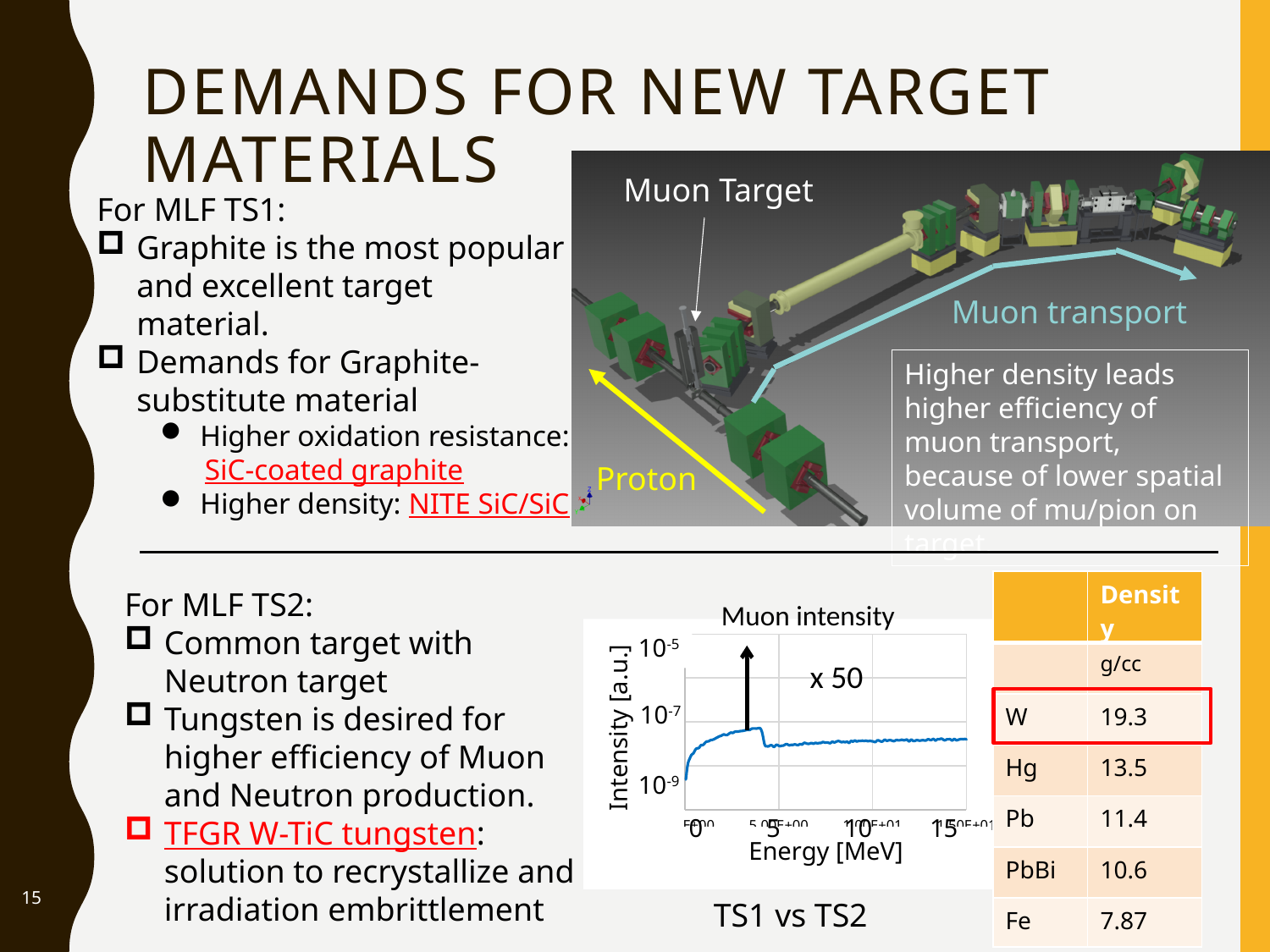
What is the title of the chart on the lower part of the slide? Muon intensity What factor is written in the annotation next to the arrow on the "Muon intensity" chart? x 50 On the "Muon intensity" chart, does the intensity rise or fall between 0 and 5 MeV? rise What kind of chart is the "Muon intensity" chart? line chart On the "Muon intensity" chart, is the intensity at 10 MeV greater or less than 10^-7? less How many lines are plotted on the "Muon intensity" chart? 1 On the "Muon intensity" chart, is the intensity at 10 MeV greater or less than 10^-9? greater